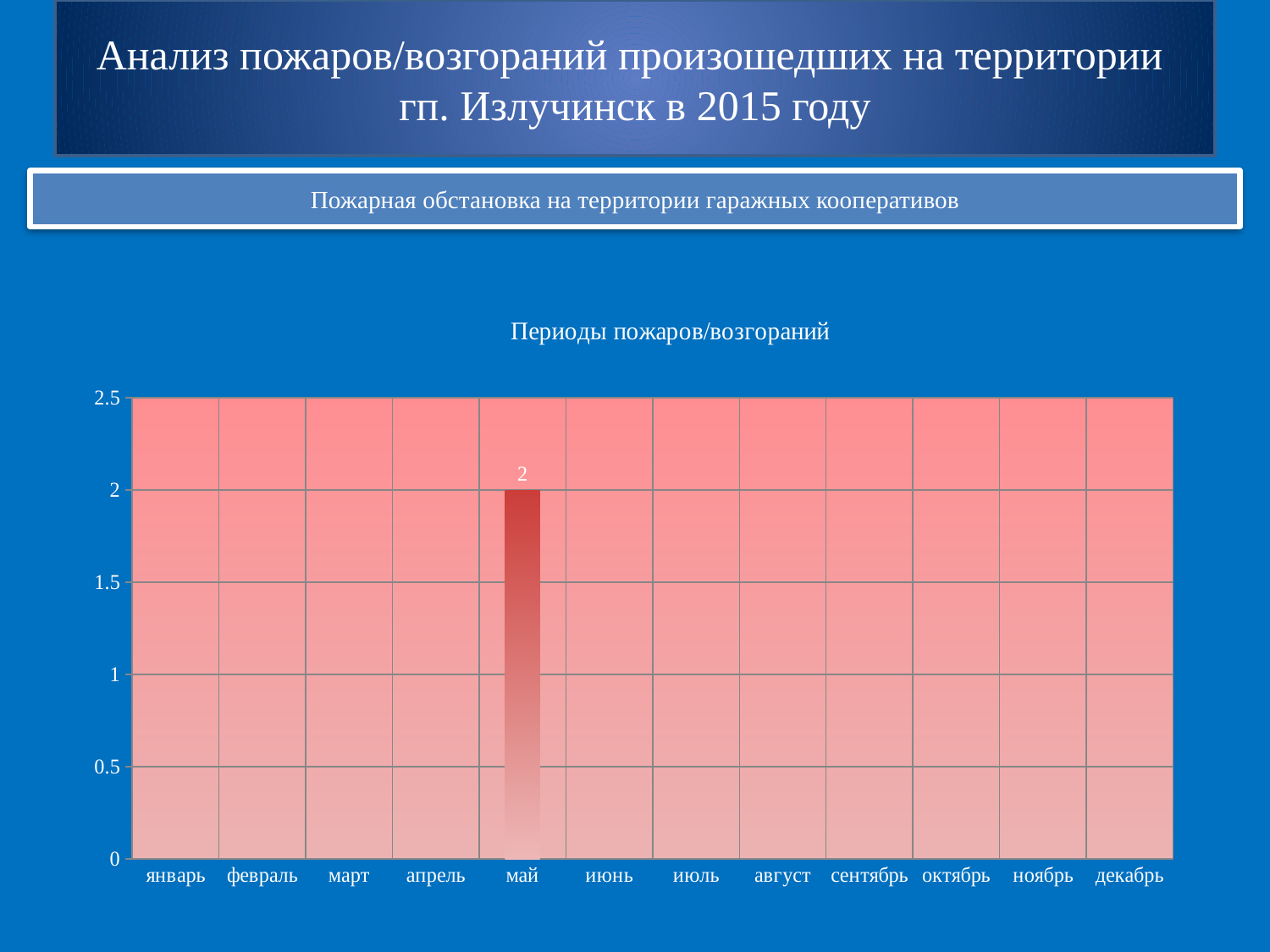
How many months are shown on the x axis of the chart? 12 What is the highest tick value shown on the y axis of the chart? 2.5 Is the value for май greater or less than 1.5? greater What is the value for май (May) in the chart? 2 Which month has the highest value in the chart? май Which month is the only one with a bar plotted in the chart? май Is the value for май greater or less than 2.5? less How many months have a visible bar in the chart? 1 What is the title of the chart? Периоды пожаров/возгораний What kind of chart is shown on the slide? bar chart